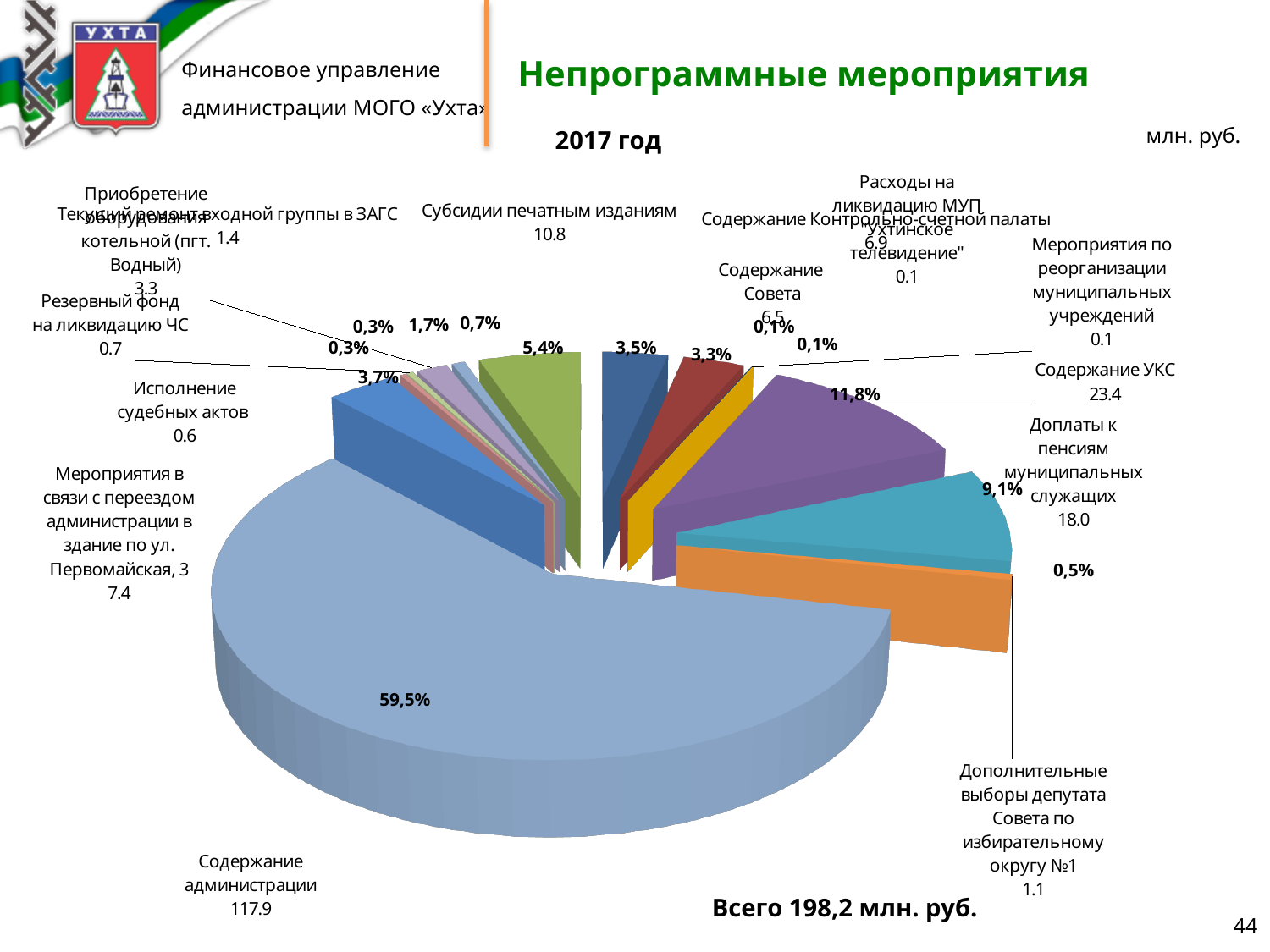
Which category has the largest share of the pie? Содержание администрации What is the total shown for all non-programme activities? 198,2 млн. руб. What year does the chart cover? 2017 What is the value for Субсидии печатным изданиям? 10.8 What is the difference between the values for Содержание УКС and Доплаты к пенсиям муниципальных служащих? 5.4 What is the value for Содержание администрации? 117.9 Which is larger: the value for Содержание Совета or the value for Содержание Контрольно-счетной палаты? Содержание Контрольно-счетной палаты What share of the pie does Содержание администрации take? 59,5% What is the value for Доплаты к пенсиям муниципальных служащих? 18.0 What is the value for Содержание УКС? 23.4 What kind of chart is shown on the slide? pie chart What share of the pie does Содержание УКС take? 11,8%